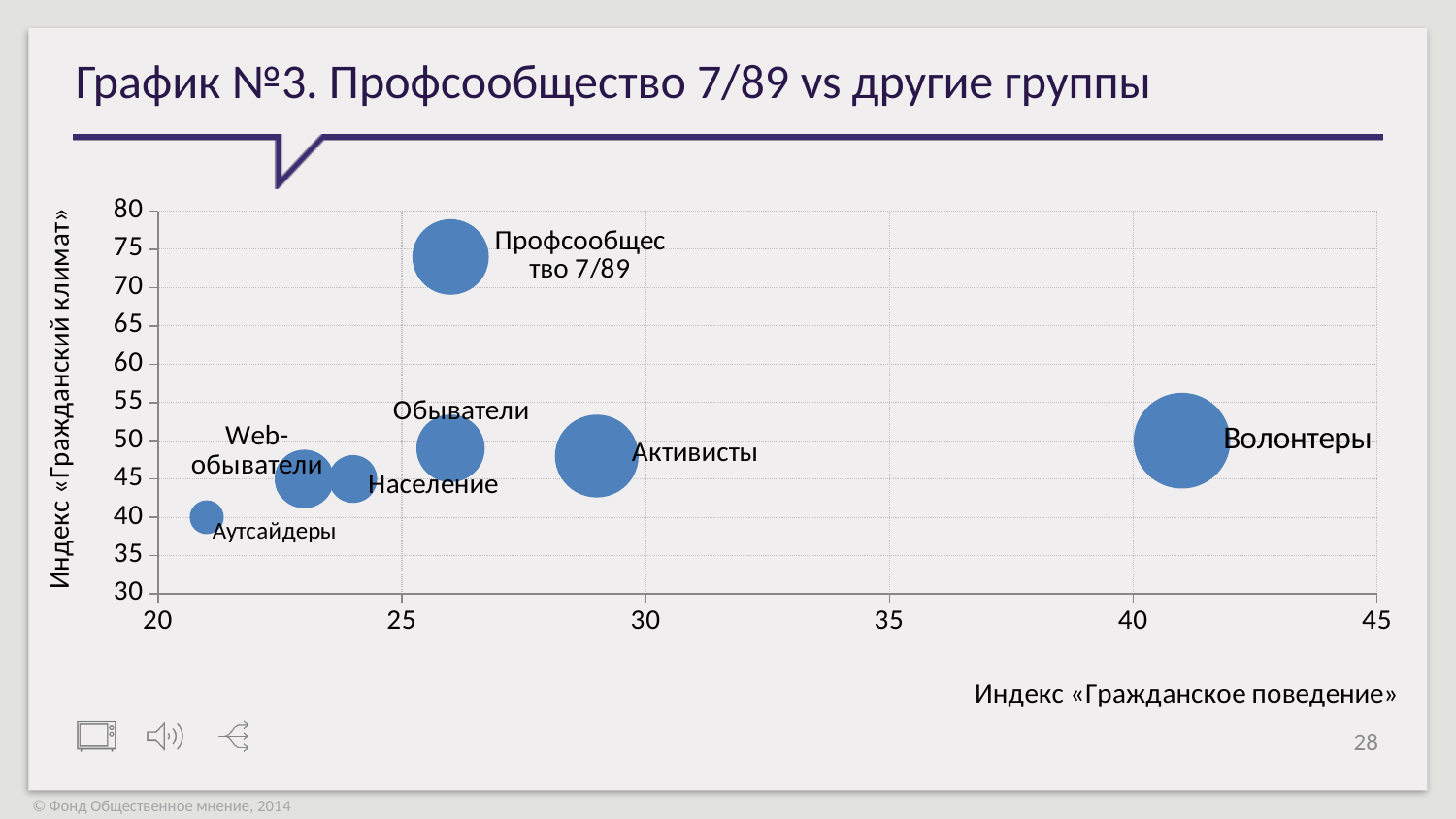
What is the title of the horizontal axis? Индекс «Гражданское поведение» Which group has the higher vertical-axis value, Профсообщество 7/89 or Обыватели? Профсообщество 7/89 What kind of chart is shown on the slide? bubble chart Is the vertical-axis value for Профсообщество 7/89 greater or less than 70? greater Is the horizontal-axis value for Волонтеры greater or less than 40? greater Which group has the highest value on the horizontal axis (Индекс «Гражданское поведение»)? Волонтеры What is the title of the vertical axis? Индекс «Гражданский климат» Which group has the lowest value on the horizontal axis (Индекс «Гражданское поведение»)? Аутсайдеры Is the horizontal-axis value for Аутсайдеры greater or less than 25? less How many groups (bubbles) are plotted on the chart? 7 Which group has the lowest value on the vertical axis (Индекс «Гражданский климат»)? Аутсайдеры Which group has the highest value on the vertical axis (Индекс «Гражданский климат»)? Профсообщество 7/89